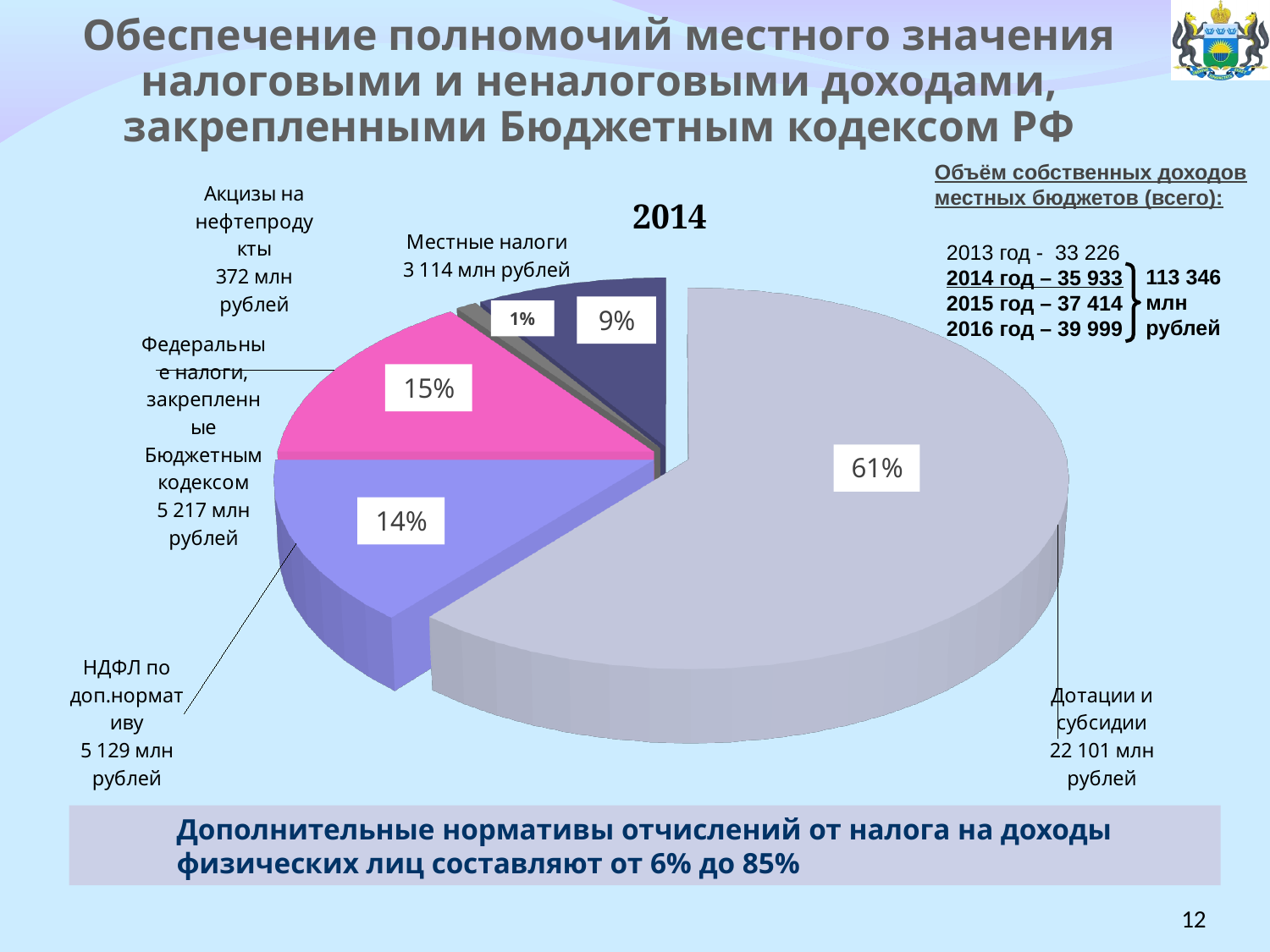
What percentage share does the slice "Акцизы на нефтепродукты" have? 1% Which slice of the pie chart is the largest? Дотации и субсидии What percentage share does the slice "Местные налоги" have? 9% How many slices does the pie chart have? 5 What is the difference in percentage points between the "Федеральные налоги" slice (15%) and the "НДФЛ по доп.нормативу" slice (14%)? 1 percentage point What kind of chart is shown on the slide? pie chart What is the title of the pie chart? 2014 What percentage share does the slice "Дотации и субсидии" have? 61% What value in million rubles is shown for "НДФЛ по доп.нормативу"? 5 129 млн рублей What value in million rubles is shown for "Дотации и субсидии"? 22 101 млн рублей Which slice of the pie chart is the smallest? Акцизы на нефтепродукты What value in million rubles is shown for "Федеральные налоги, закрепленные Бюджетным кодексом"? 5 217 млн рублей